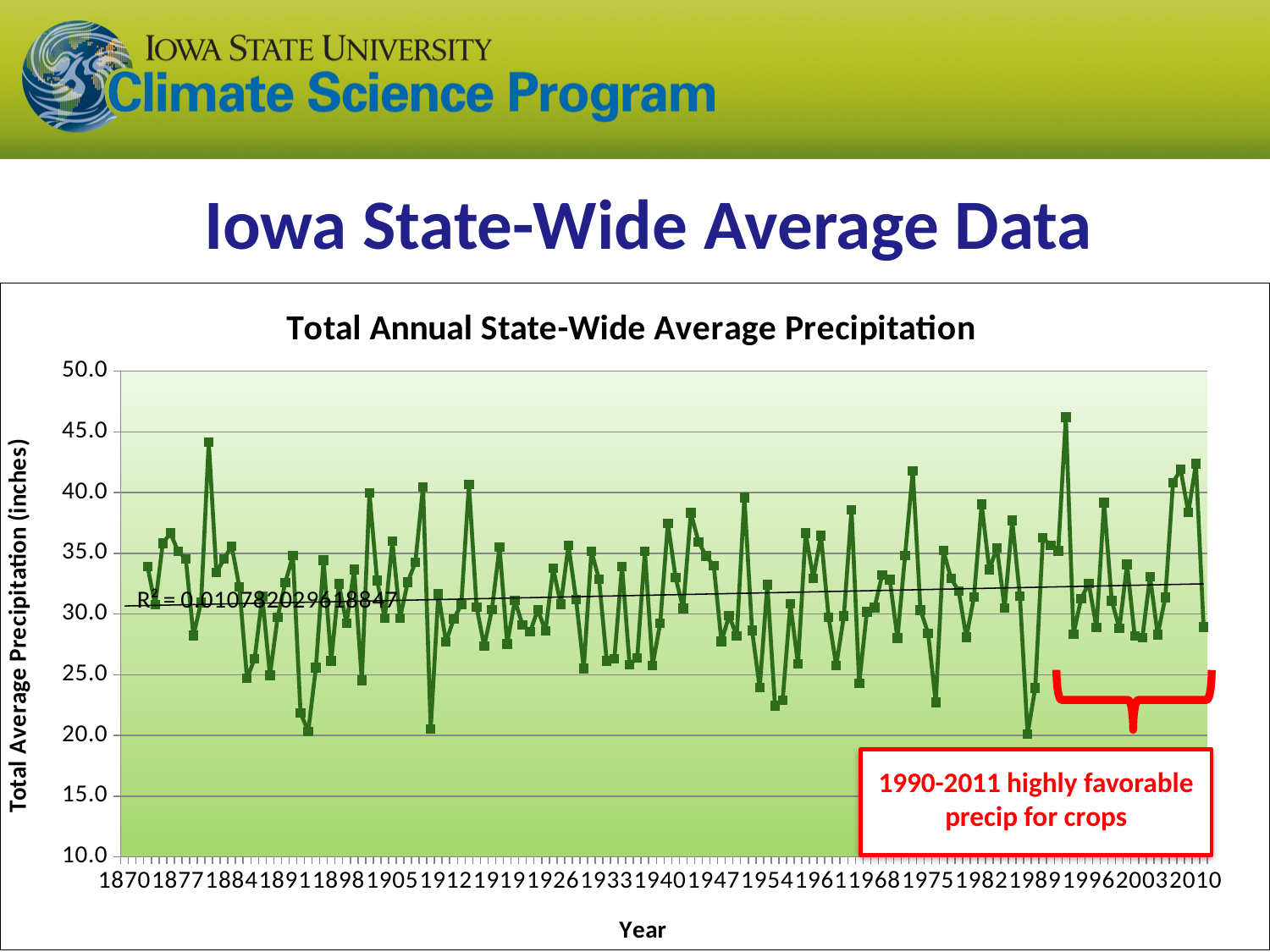
Is the lowest plotted precipitation value greater or less than 15.0? greater What R² value is printed on the chart? R² = 0.010782029618847 What is the title of the chart? Total Annual State-Wide Average Precipitation Does the fitted trend line rise or fall from left to right across the years? rises slightly Is the lowest plotted precipitation value greater or less than 25.0? less What kind of chart is shown on the slide? line chart Is the highest plotted precipitation value greater or less than 45.0? greater